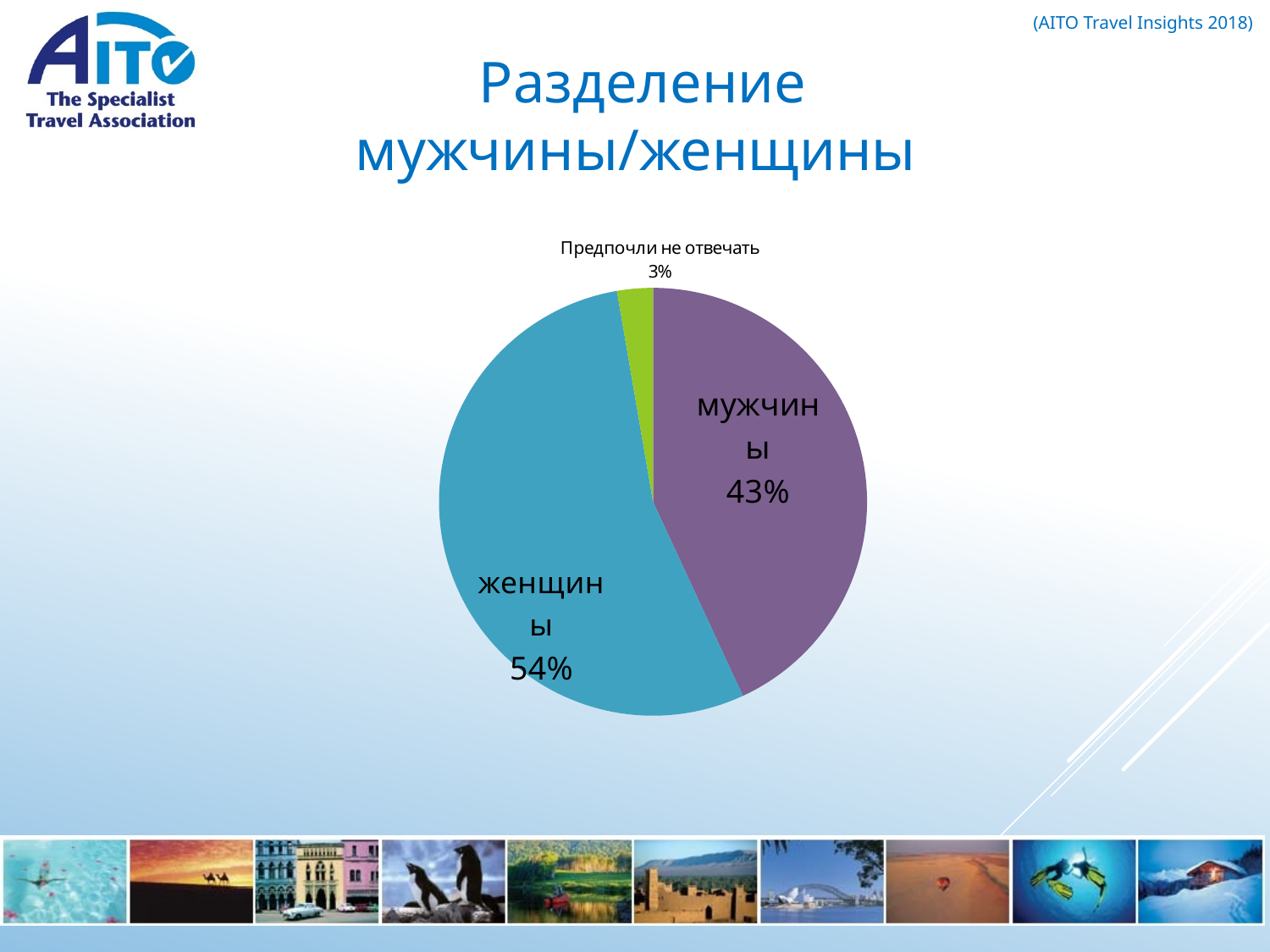
What share of the pie is labelled женщины? 54% What is the difference in percentage points between the женщины and мужчины slices? 11 What kind of chart is shown on the slide? pie chart What share of the pie is labelled Предпочли не отвечать? 3% What share of the pie is labelled мужчины? 43% Which slice of the pie is the largest? женщины What is the title of the slide? Разделение мужчины/женщины What colour is the женщины slice? blue How many slices does the pie chart have? 3 Which slice is larger, мужчины or женщины? женщины Which slice of the pie is the smallest? Предпочли не отвечать